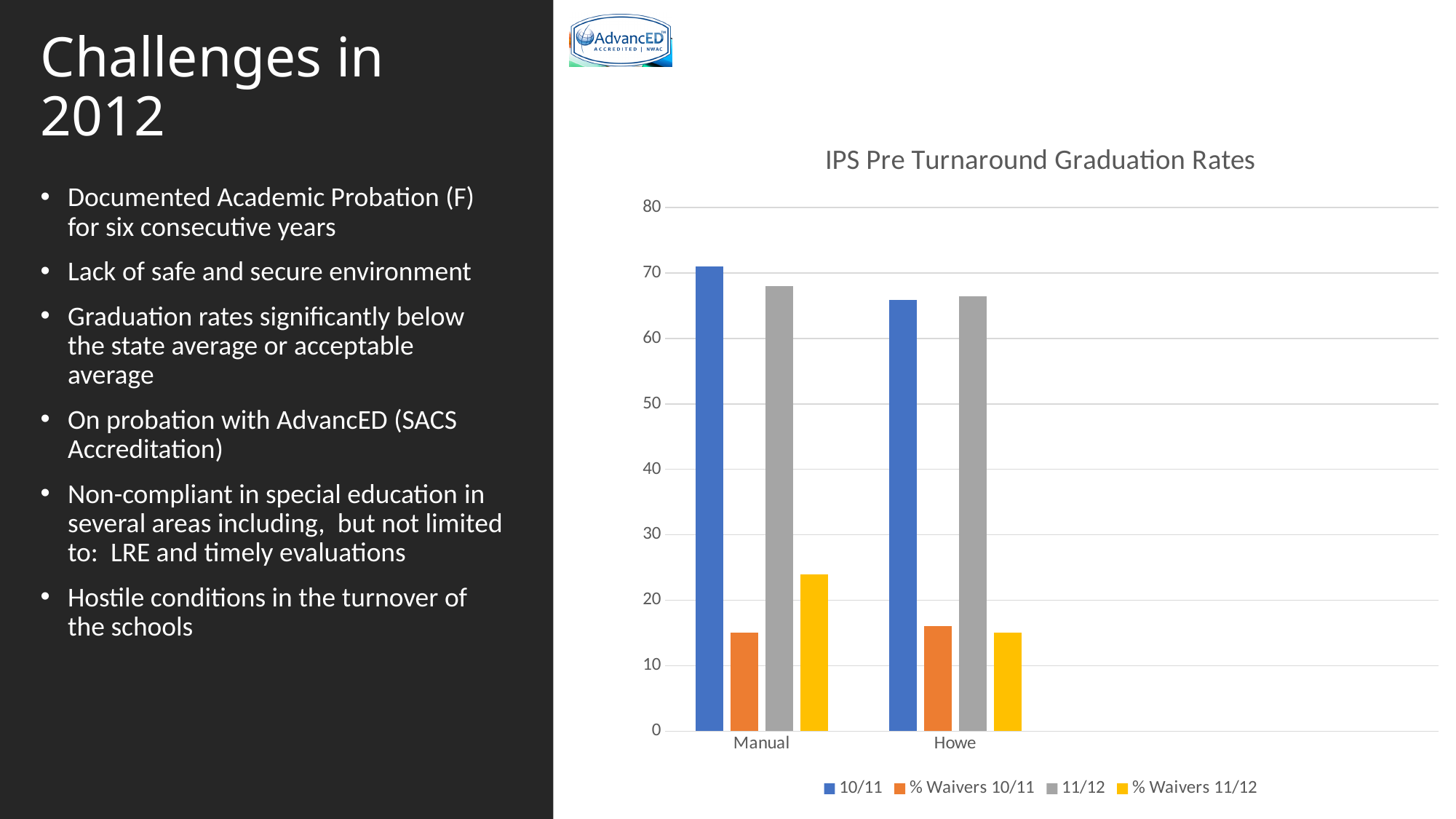
Is the 10/11 value for Howe greater or less than 70? less What is the title of the chart? IPS Pre Turnaround Graduation Rates How many schools (categories) are shown on the x axis of the chart? 2 Is the % Waivers 11/12 value for Manual greater or less than 20? greater Which bar is the tallest in the chart? 10/11 for Manual How many series does the chart legend list? 4 Which school has the higher % Waivers 11/12 value, Manual or Howe? Manual Is the 10/11 value for Manual greater or less than 60? greater What kind of chart is shown on the slide? bar chart Which school has the higher 10/11 graduation rate, Manual or Howe? Manual Which series is shown in yellow in the chart? % Waivers 11/12